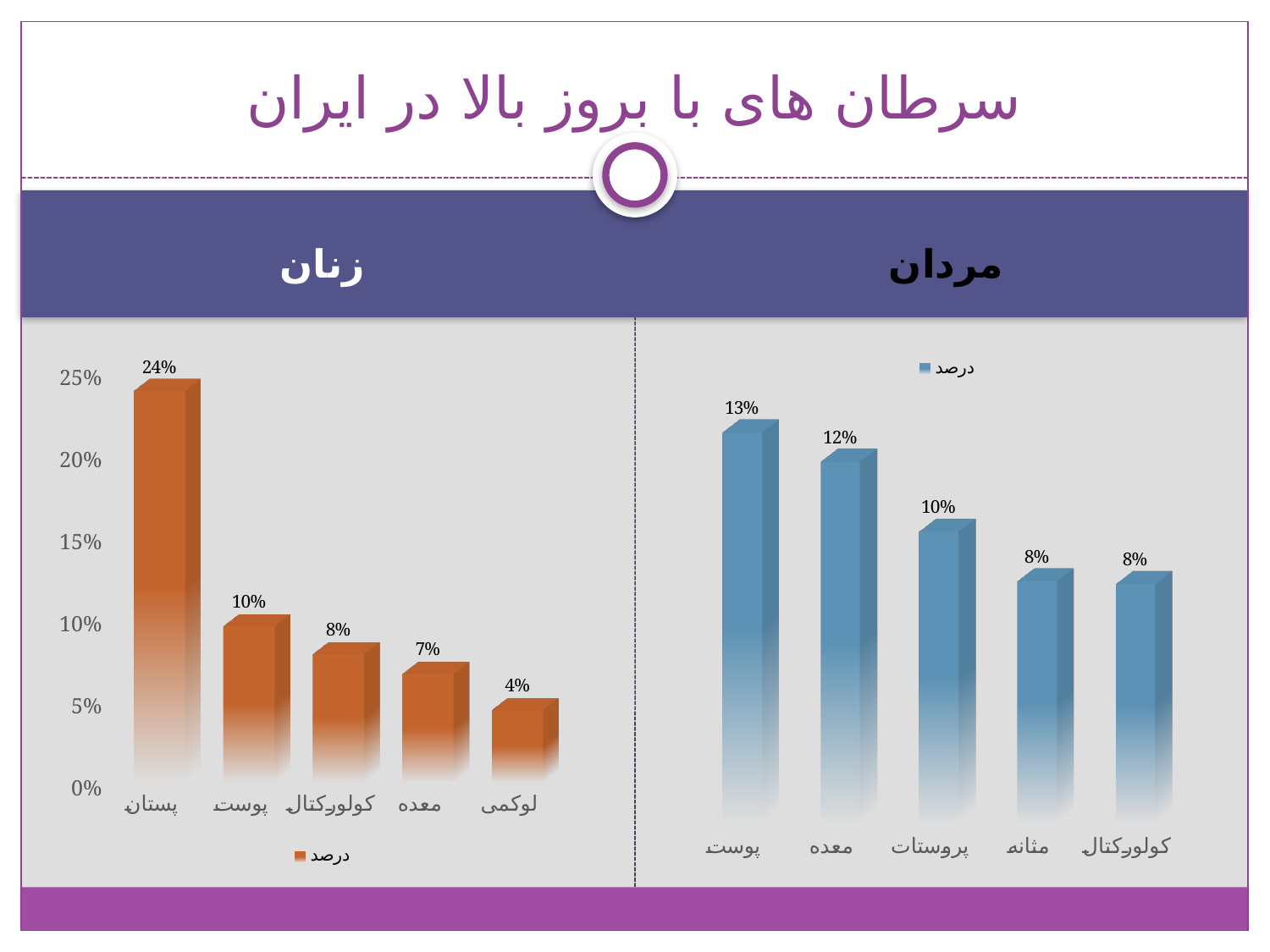
In the right chart (مردان), is the value for معده greater or less than 10%? greater In the left chart (زنان), which category has the lowest value? لوکمی What kind of chart is the right chart (مردان)? bar chart In the left chart (زنان), what is the value for پستان? 24% In the right chart (مردان), what is the value for پروستات? 10% In the left chart (زنان), do the values rise or fall from left to right along the x axis? fall In the right chart (مردان), what is the difference between the values for پوست and مثانه? 5% In the left chart (زنان), what is the difference between the values for پستان and پوست? 14% How many series does the legend of the right chart (مردان) list? 1 How many categories are shown in the left chart (زنان)? 5 In the right chart (مردان), which category has the highest value? پوست In the left chart (زنان), which is larger, the value for کولورکتال or the value for معده? کولورکتال